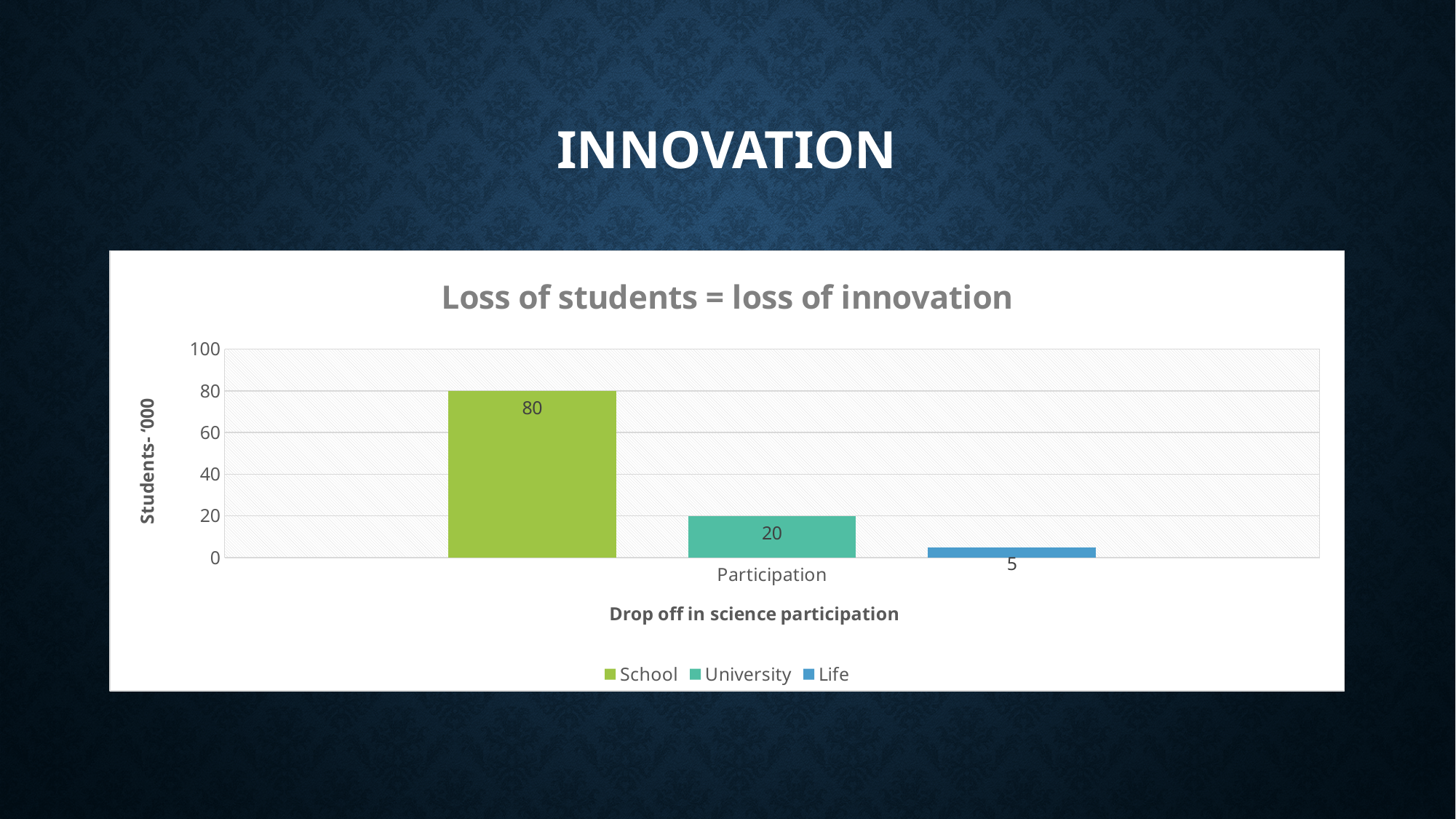
What is the value for University? 20 Which series has the lowest value? Life Which series has the highest value? School What is the label of the vertical axis? Students- '000 What kind of chart is shown? Bar chart What is the value for School? 80 What is the difference between the University and Life values? 15 How many series does the legend list? 3 What is the value for Life? 5 What is the title of the chart? Loss of students = loss of innovation What is the difference between the School and University values? 60 Which is larger, the value for University or the value for Life? University